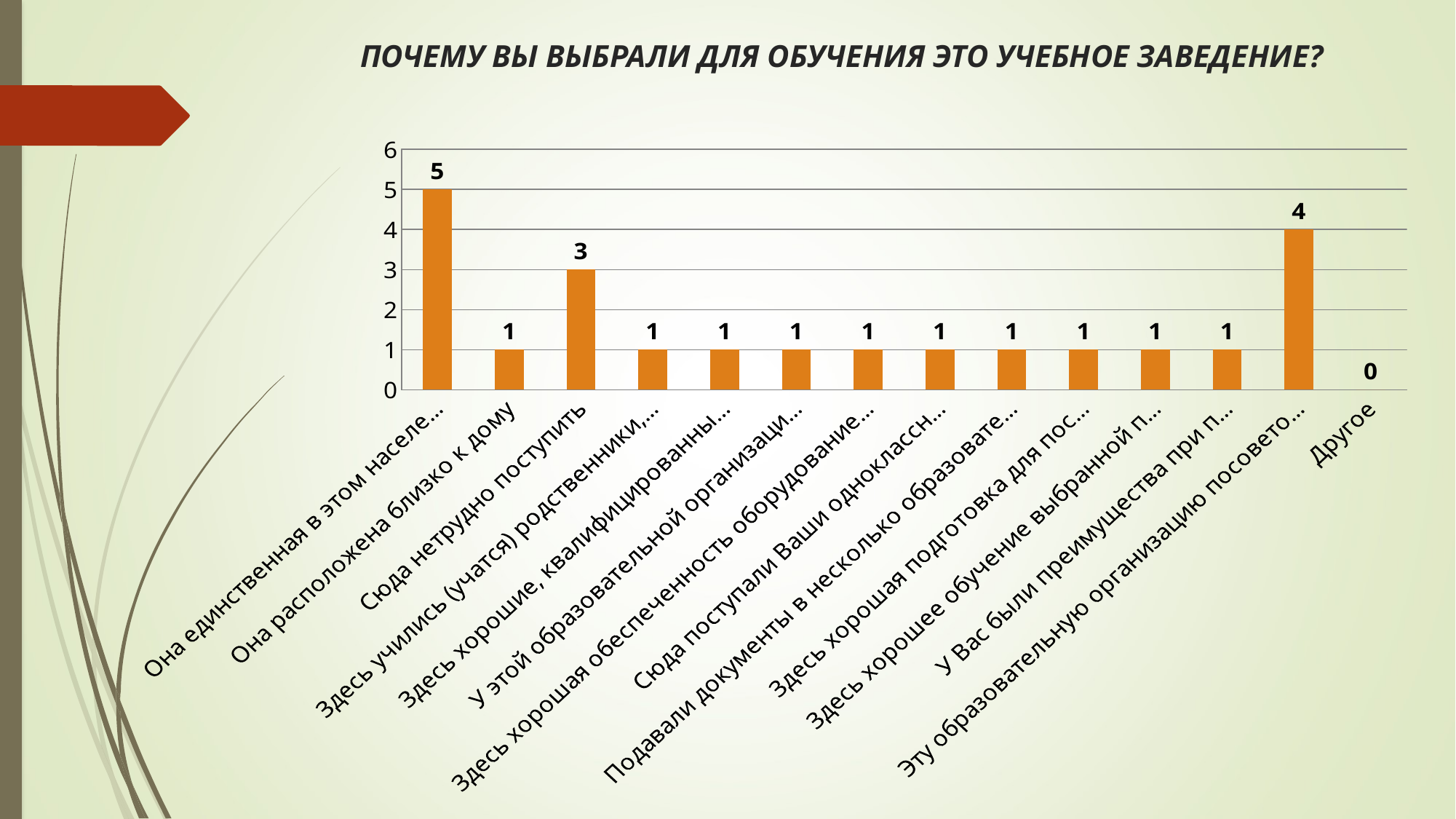
What is the difference between the value for "Она единственная в этом населе..." and the value for "Сюда нетрудно поступить"? 2 Which category has the lowest value? Другое Is the value for "Она единственная в этом населе..." greater or less than 4? greater Which category has the highest value? Она единственная в этом населе... What is the value for "Она расположена близко к дому"? 1 How many categories are shown on the x axis? 14 What is the value for "Сюда нетрудно поступить"? 3 How many categories have a value of 1? 10 What is the value for "Другое"? 0 What type of chart is shown on the slide? bar chart Which is larger: the value for "Эту образовательную организацию посовето..." or the value for "Сюда нетрудно поступить"? Эту образовательную организацию посовето... What is the title of the chart? ПОЧЕМУ ВЫ ВЫБРАЛИ ДЛЯ ОБУЧЕНИЯ ЭТО УЧЕБНОЕ ЗАВЕДЕНИЕ?